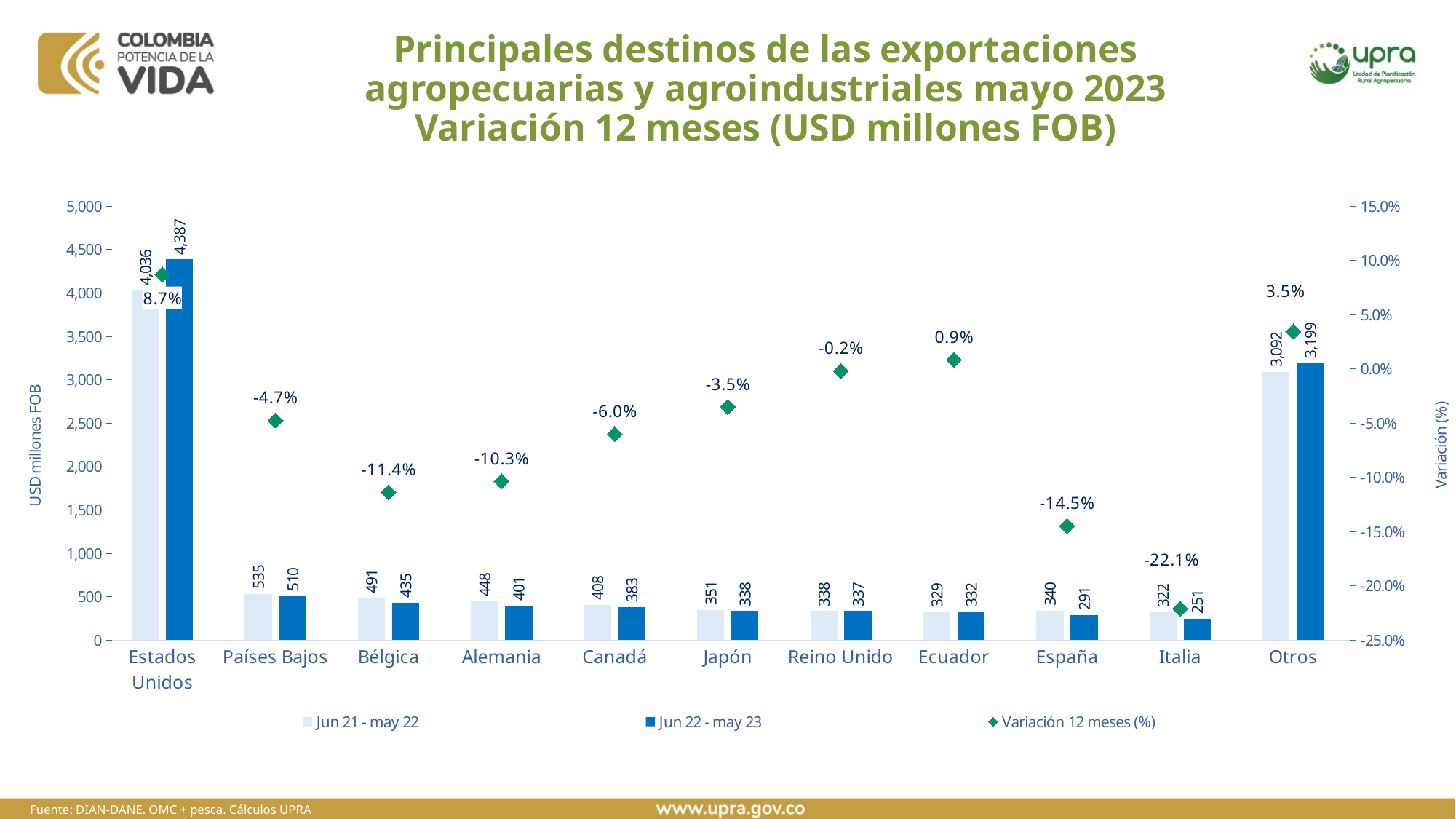
What is the label of the left vertical axis? USD millones FOB Which is larger for España: the Jun 21 - may 22 value or the Jun 22 - may 23 value? Jun 21 - may 22 How many series does the legend list? 3 Excluding Otros, which country has the lowest value in the Jun 22 - may 23 series? Italia Which category has the highest Variación 12 meses (%) value? Estados Unidos What is the difference between the Jun 22 - may 23 and Jun 21 - may 22 values for Estados Unidos? 351 What is the value for Estados Unidos in the Jun 22 - may 23 series? 4,387 What is the Variación 12 meses (%) value for Italia? -22.1% How many categories are shown on the x axis? 11 What is the Variación 12 meses (%) value for Ecuador? 0.9% What is the value for Bélgica in the Jun 21 - may 22 series? 491 What kind of chart is shown on the slide? Bar chart with a marker series for the percentage variation